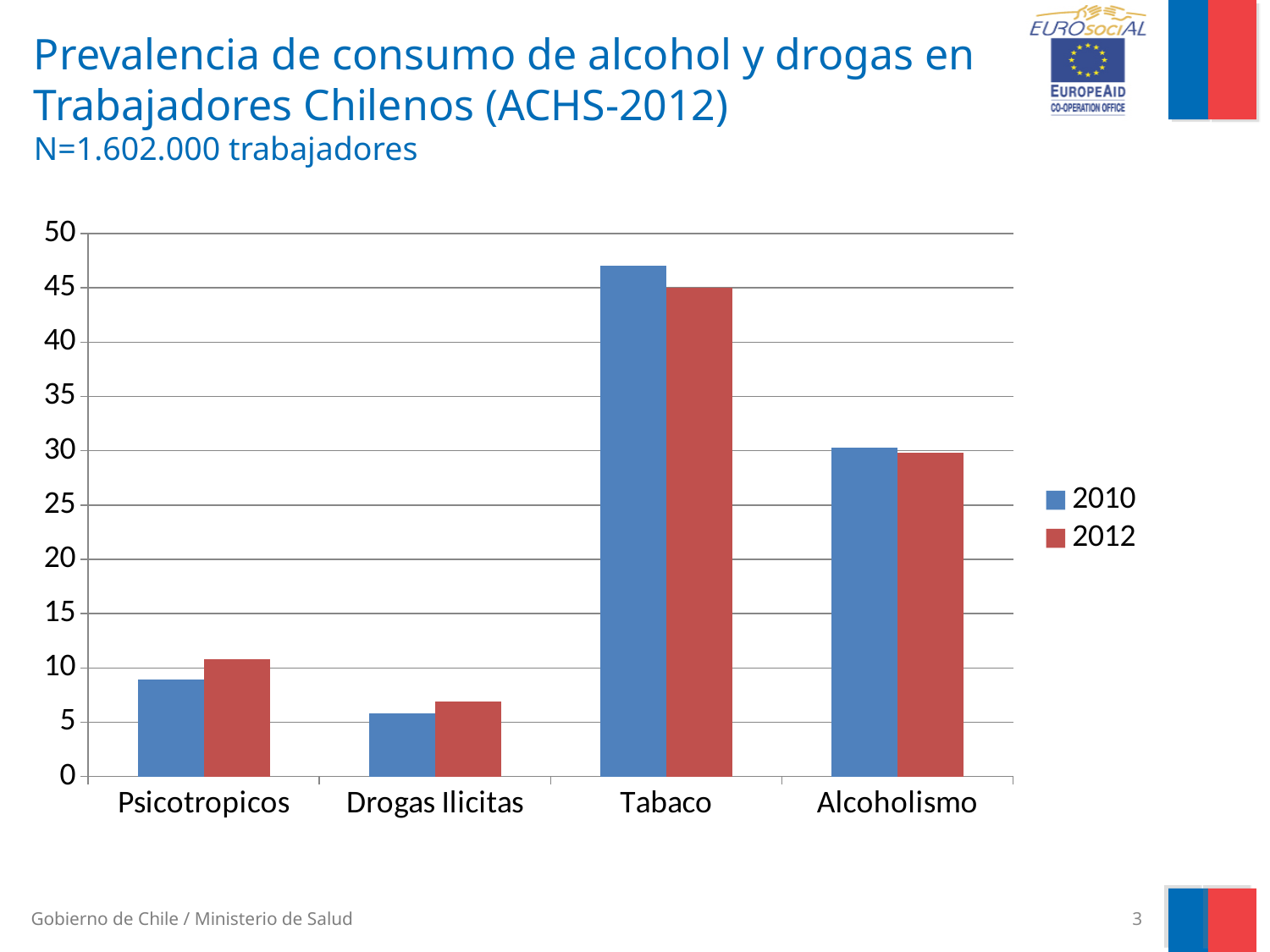
Which category has the lowest value for 2010? Drogas Ilicitas For Psicotropicos, which year has the larger value, 2010 or 2012? 2012 Is the value for Psicotropicos in 2012 greater or less than 10? greater Is the value for Drogas Ilicitas in 2010 greater or less than 10? less Which category has the lowest value for 2012? Drogas Ilicitas How many series does the legend list? 2 What kind of chart is shown on the slide? bar chart How many categories are shown on the x axis of the chart? 4 Which series is shown in red in the legend? 2012 Is the value for Tabaco in 2010 greater or less than 45? greater For Tabaco, which year has the larger value, 2010 or 2012? 2010 Which category has the highest value for 2010? Tabaco